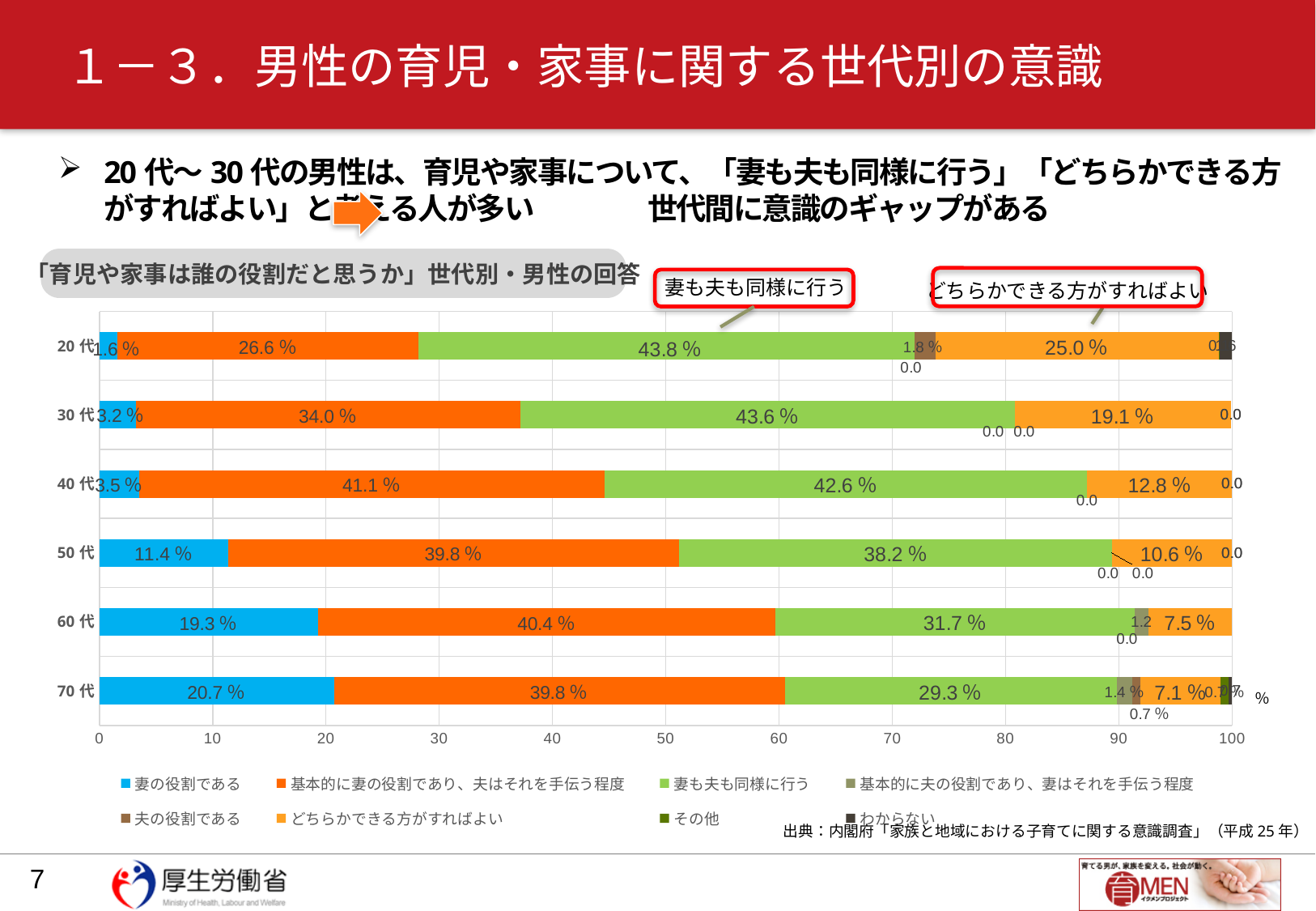
What is the value of 基本的に妻の役割であり、夫はそれを手伝う程度 for 60代? 40.4 % Which has the larger value for 基本的に妻の役割であり、夫はそれを手伝う程度, 30代 or 40代? 40代 Which age group has the highest value for どちらかできる方がすればよい? 20代 How many age groups are shown in the chart? 6 What is the value of どちらかできる方がすればよい for 40代? 12.8 % Which age group has the lowest value for 妻の役割である? 20代 What is the value of 妻も夫も同様に行う for 20代? 43.8 % What kind of chart is shown on the slide? Stacked bar chart What is the difference between the 妻も夫も同様に行う values for 20代 and 70代? 14.5 % What is the value of 妻の役割である for 70代? 20.7 % How many series does the legend list? 8 Which age group has the highest value for 妻の役割である? 70代